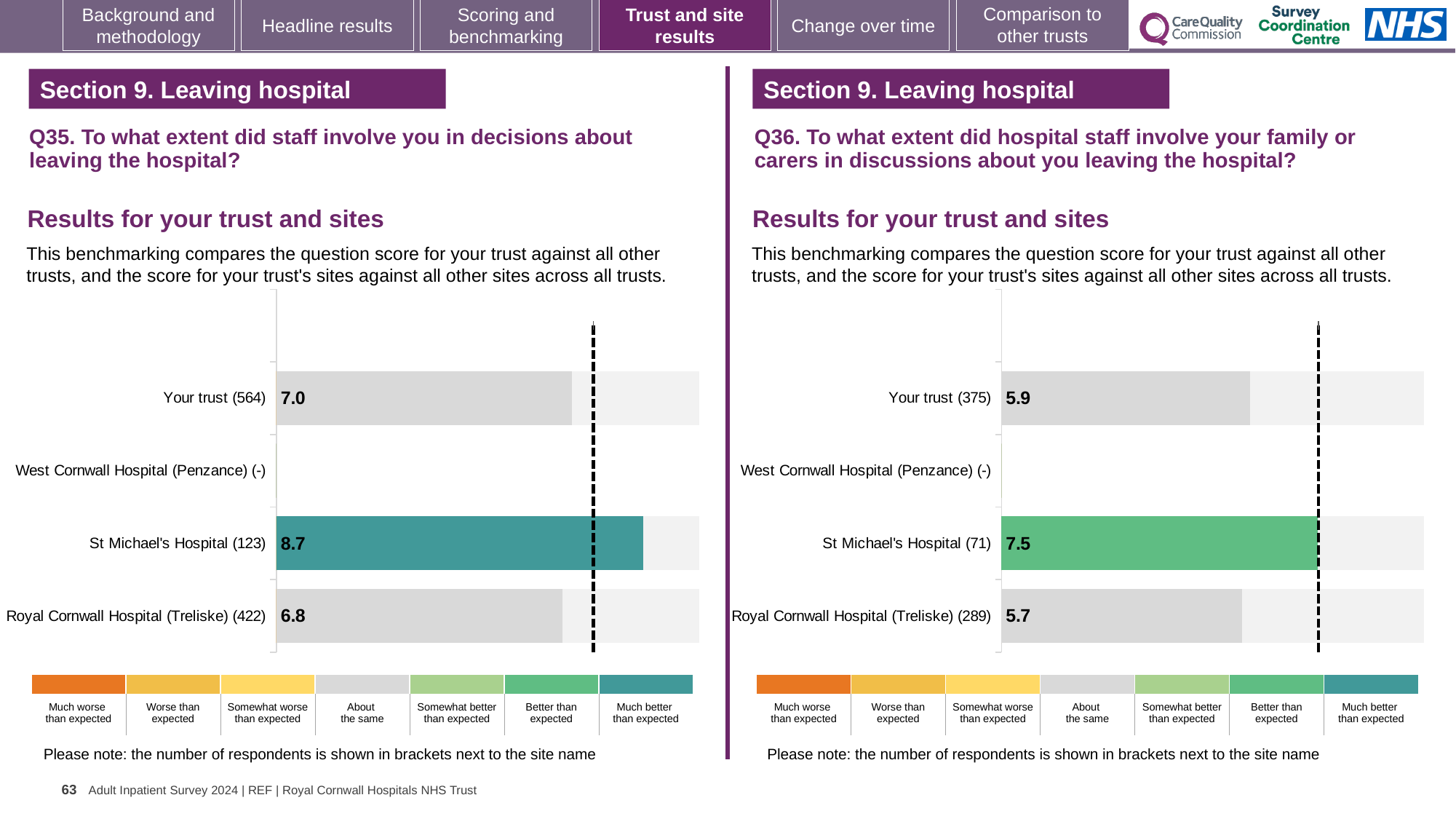
In the Q36 chart on the right, which has the larger score: Your trust or Royal Cornwall Hospital (Treliske)? Your trust In the Q35 chart on the left, which of the labelled bars has the lowest score? Royal Cornwall Hospital (Treliske) In the Q35 chart on the left, what is the score for Royal Cornwall Hospital (Treliske)? 6.8 What type of chart is used in the Q35 chart on the left? Bar chart In the Q36 chart on the right, which site has the highest score? St Michael's Hospital In the Q35 chart on the left, how many respondents are shown in brackets for St Michael's Hospital? 123 In the Q36 chart on the right, what is the difference between the scores for St Michael's Hospital and Your trust? 1.6 In the Q36 chart on the right, what is the score for Your trust? 5.9 In the Q35 chart on the left, what is the score for Your trust? 7.0 In the Q35 chart on the left, what is the difference between the scores for St Michael's Hospital and Royal Cornwall Hospital (Treliske)? 1.9 In the Q36 chart on the right, what is the score for Royal Cornwall Hospital (Treliske)? 5.7 In the Q35 chart on the left, what is the score for St Michael's Hospital? 8.7